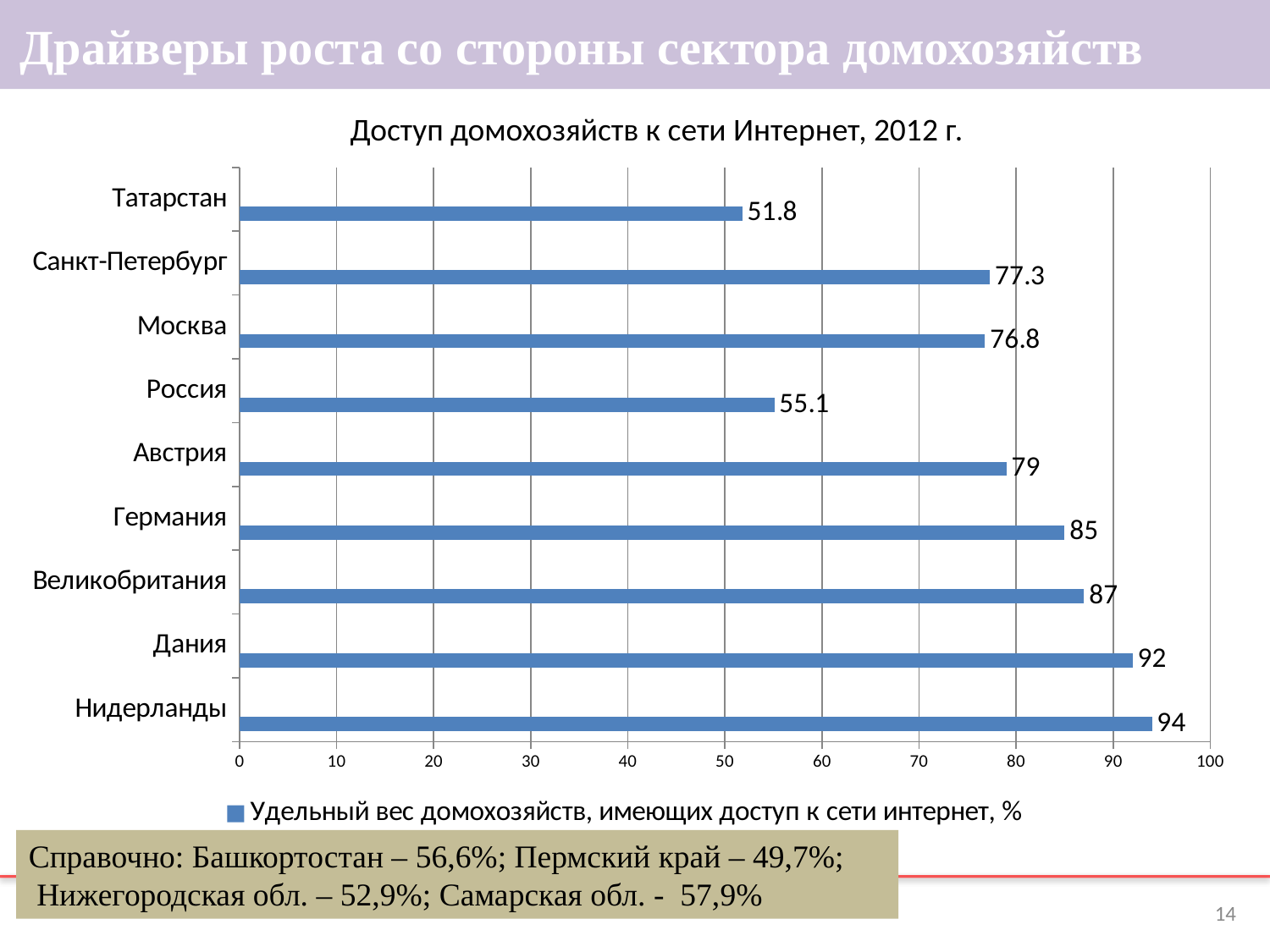
How many categories are shown in the chart? 9 Which is larger, the value for Австрия or the value for Москва? Австрия What is the value for Нидерланды? 94 What is the value for Россия? 55.1 Is the value for Великобритания greater or less than 80? greater What is the value for Татарстан? 51.8 Which category has the highest value? Нидерланды What is the difference between the values for Санкт-Петербург and Татарстан? 25.5 What is the difference between the values for Дания and Германия? 7 What is the title of the chart? Доступ домохозяйств к сети Интернет, 2012 г. What kind of chart is shown on the slide? bar chart Which category has the lowest value? Татарстан